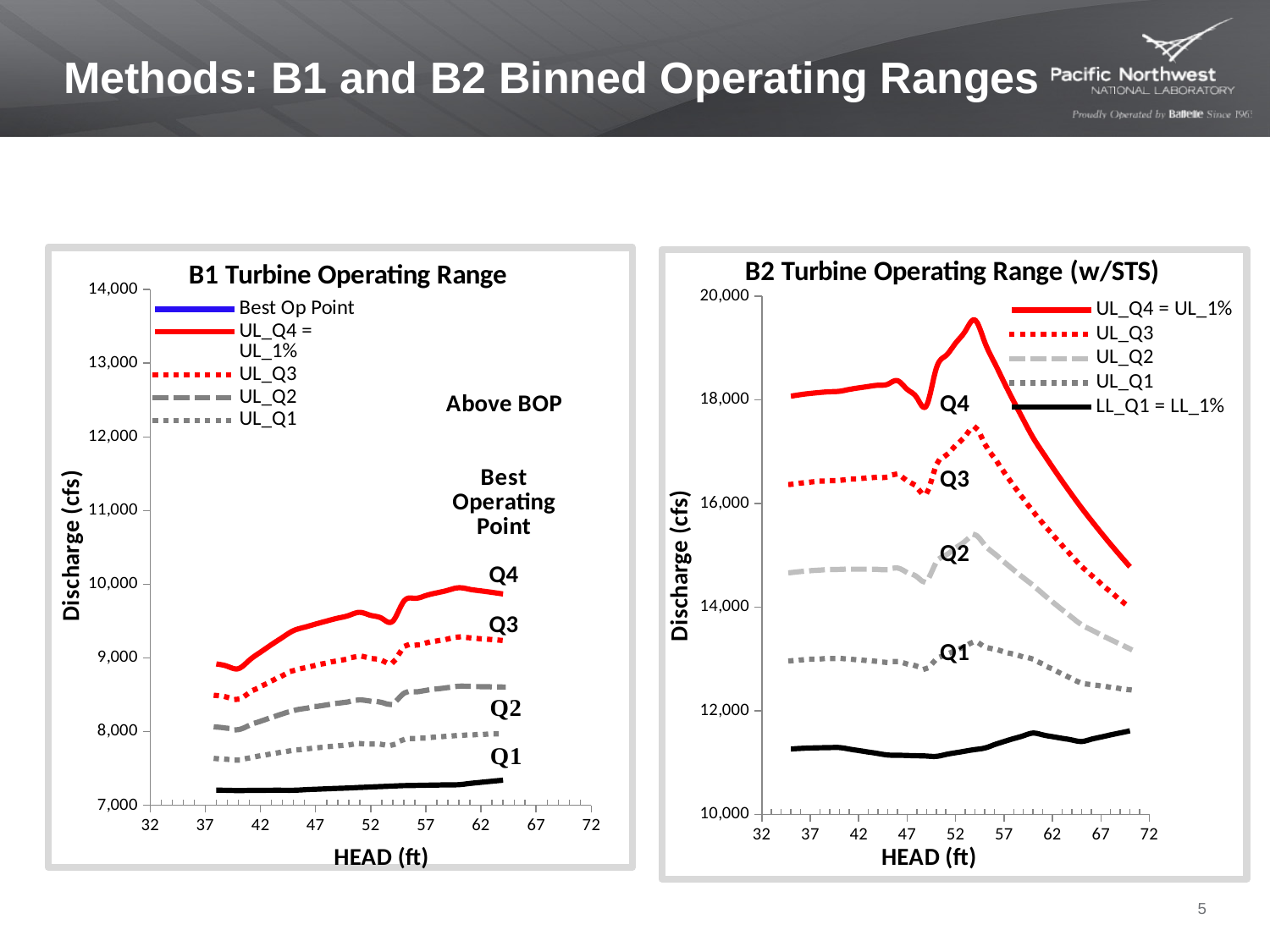
In the B2 Turbine Operating Range (w/STS) chart, is the UL_Q4 line at a head of 52 ft greater or less than 18,000 cfs? greater In the B2 Turbine Operating Range (w/STS) chart, does the UL_Q4 line rise or fall as head increases from 57 ft to 70 ft? fall In the B2 Turbine Operating Range (w/STS) chart, which series has the highest discharge values? UL_Q4 = UL_1% In the B2 Turbine Operating Range (w/STS) chart, which series has the lowest discharge values? LL_Q1 = LL_1% What kind of chart is the B1 Turbine Operating Range chart? line chart How many series does the legend of the B1 Turbine Operating Range chart list? 5 In the B2 Turbine Operating Range (w/STS) chart, is the LL_Q1 line at a head of 52 ft greater or less than 12,000 cfs? less In the B1 Turbine Operating Range chart, is the Q4 line at a head of 47 ft greater or less than 10,000 cfs? less In the B1 Turbine Operating Range chart, at a head of 57 ft, which is larger: the Q3 line or the Q2 line? Q3 How many series does the legend of the B2 Turbine Operating Range (w/STS) chart list? 5 What is the label on the x axis of the B2 Turbine Operating Range (w/STS) chart? HEAD (ft)